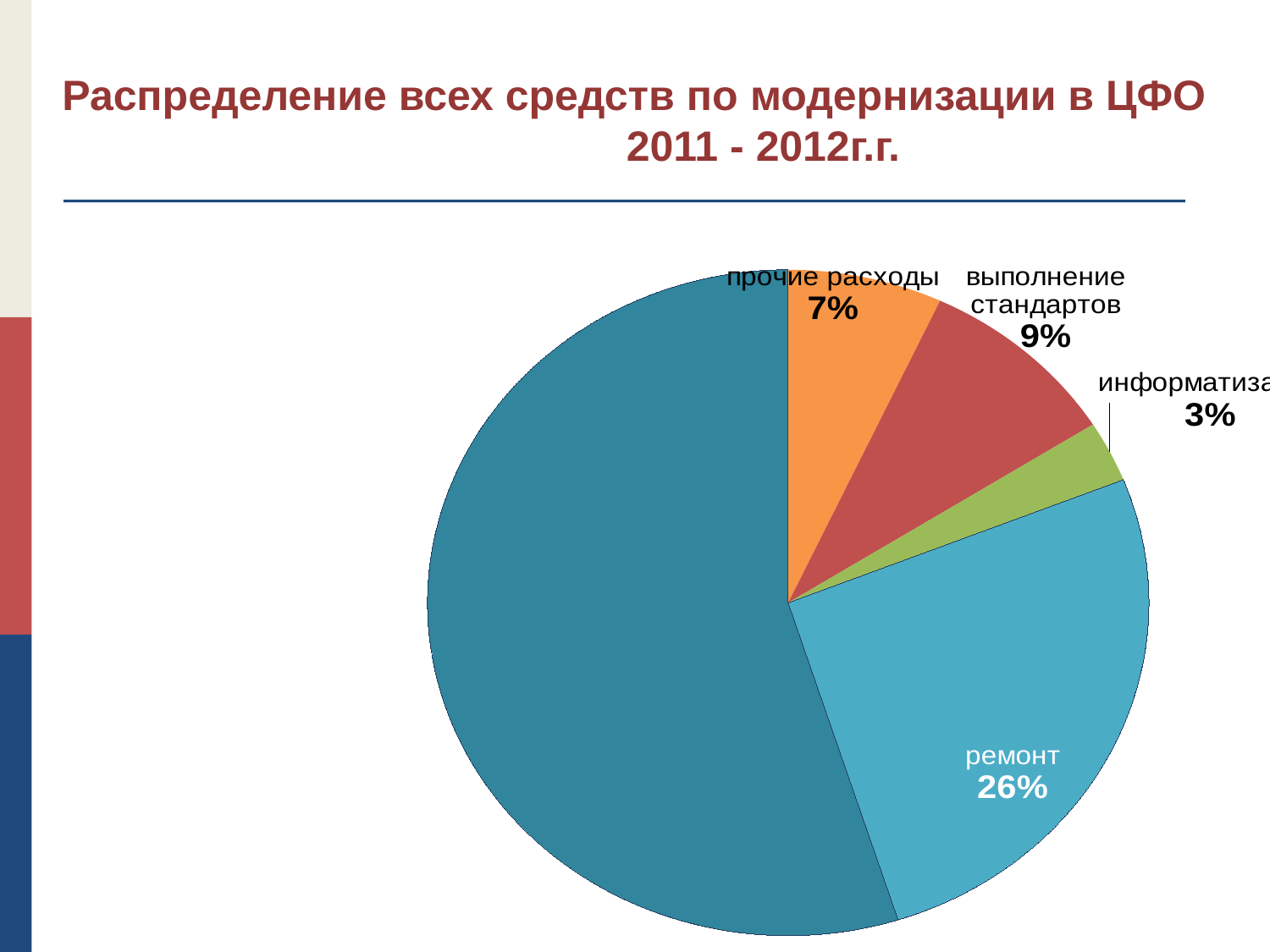
How many percentage points larger is the ремонт share than the прочие расходы share? 19% Which is larger: the share for ремонт or the share for выполнение стандартов? ремонт What is the difference between the выполнение стандартов share and the прочие расходы share? 2% How many slices does the pie chart have? 5 What share of the funds goes to выполнение стандартов? 9% What share of the funds goes to прочие расходы? 7% What kind of chart is shown on the slide? pie chart What share of the funds goes to ремонт? 26% Among the labelled slices, which category has the largest share? ремонт What is the smallest percentage printed on the pie chart? 3% What is the title of the slide? Распределение всех средств по модернизации в ЦФО 2011 - 2012г.г. Which is larger: the share for выполнение стандартов or the share for прочие расходы? выполнение стандартов